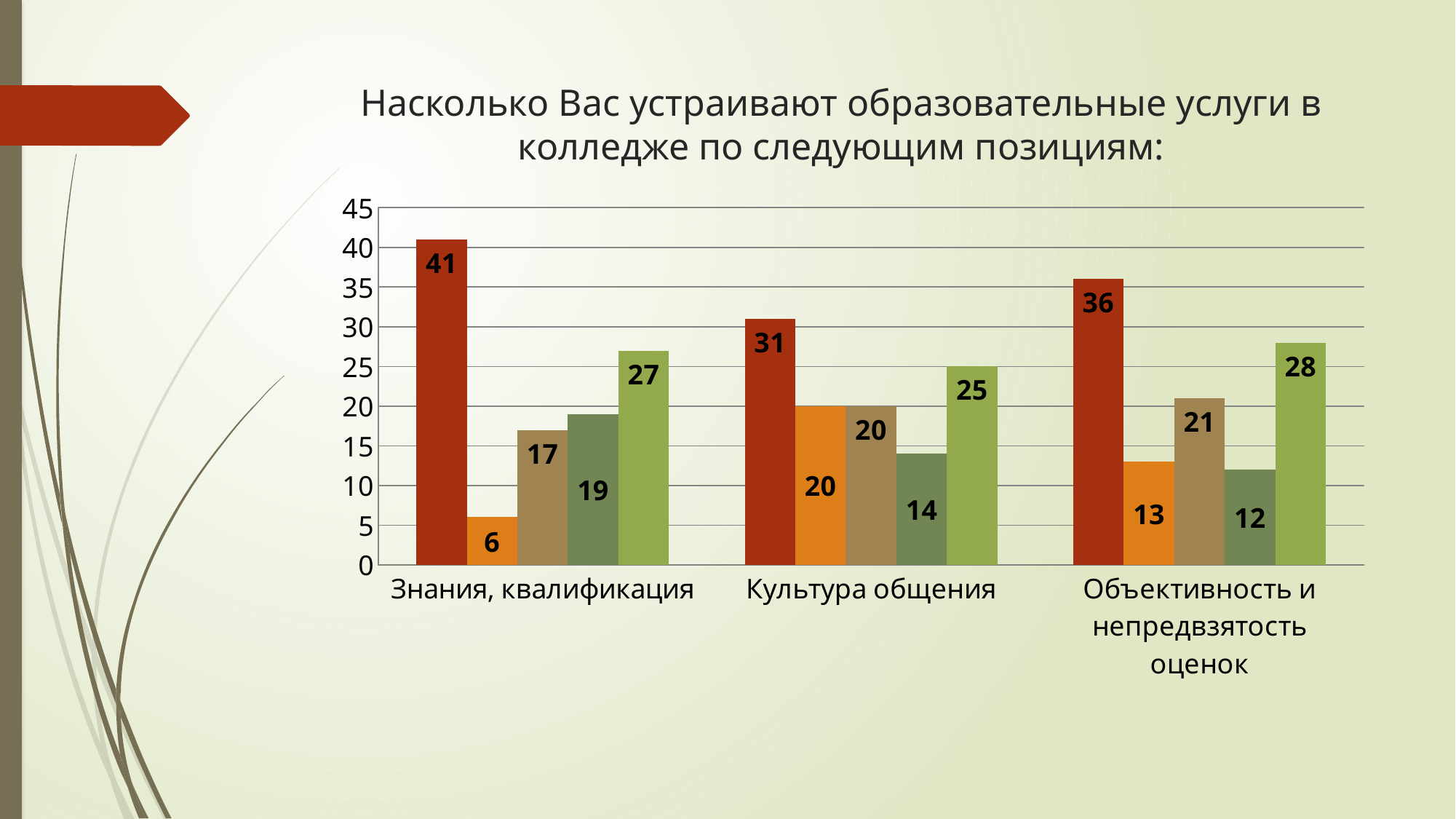
What is the value of the orange bar for 'Знания, квалификация'? 6 What is the title of the chart? Насколько Вас устраивают образовательные услуги в колледже по следующим позициям: Which is larger for 'Объективность и непредвзятость оценок': the tan bar or the dark green bar? The tan bar What is the difference between the dark red bar and the light green bar for 'Культура общения'? 6 What is the value of the dark green bar for 'Культура общения'? 14 Which category has the highest dark red bar? Знания, квалификация How many categories are shown on the x axis of the chart? 3 What is the value of the light green bar for 'Объективность и непредвзятость оценок'? 28 How many bars are shown for each category in the chart? 5 What type of chart is shown on the slide? Bar chart What is the value of the dark red bar for 'Знания, квалификация'? 41 Which category has the lowest orange bar? Знания, квалификация